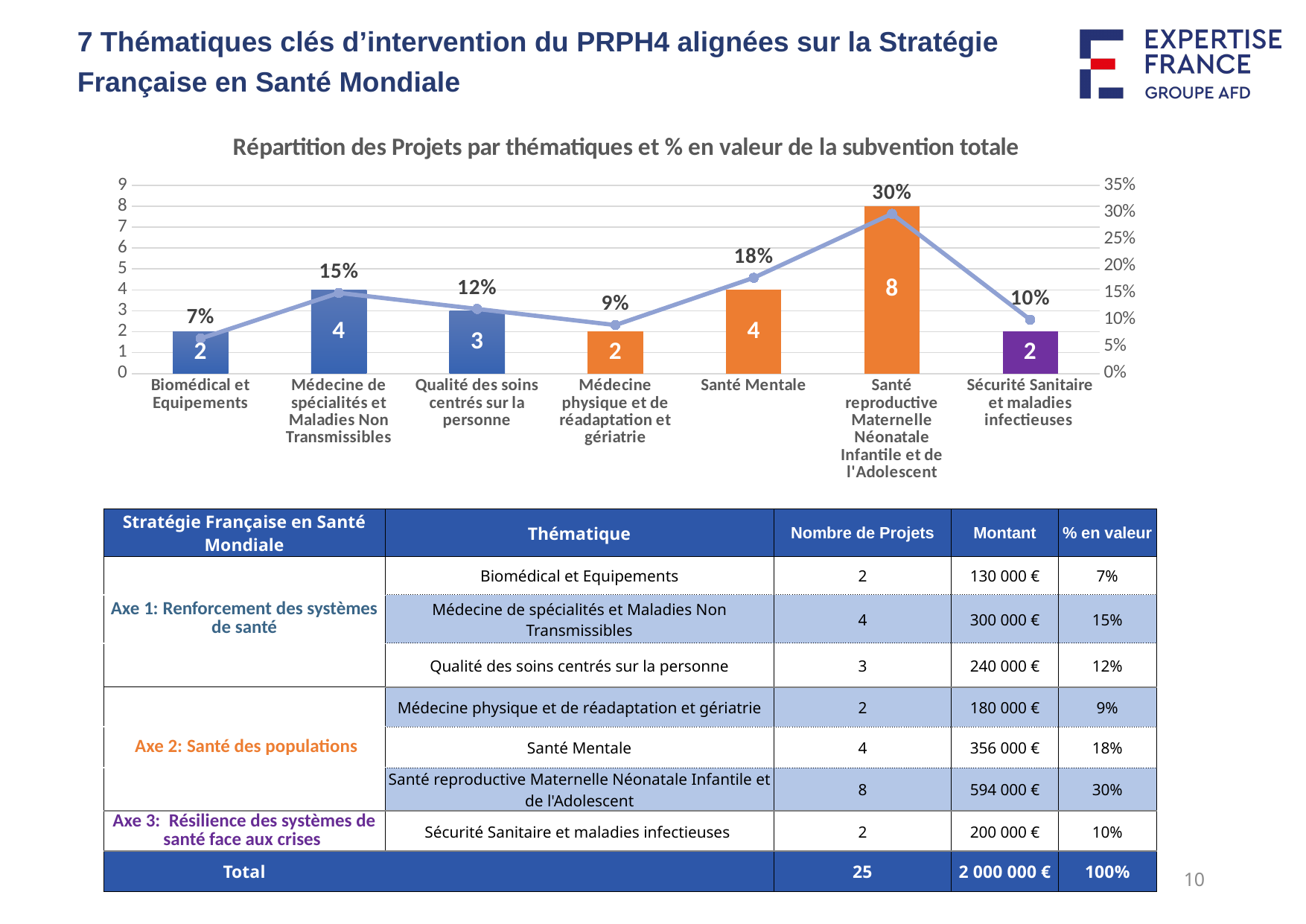
Which thematic has the lowest percentage of the total subvention in the chart? Biomédical et Equipements What percentage of the total subvention is shown for Médecine physique et de réadaptation et gériatrie? 9% What is the title of the chart? Répartition des Projets par thématiques et % en valeur de la subvention totale What is the difference in number of projects between Santé reproductive Maternelle Néonatale Infantile et de l'Adolescent and Qualité des soins centrés sur la personne? 5 How many thematic categories are plotted on the x axis of the chart? 7 What is the difference in percentage points between Santé Mentale and Qualité des soins centrés sur la personne? 6% Which thematic has the highest number of projects in the chart? Santé reproductive Maternelle Néonatale Infantile et de l'Adolescent What is the percentage value shown for Santé reproductive Maternelle Néonatale Infantile et de l'Adolescent? 30% What kind of chart is shown on the slide? A bar chart combined with a line chart Which has a larger share of the subvention: Médecine de spécialités et Maladies Non Transmissibles or Sécurité Sanitaire et maladies infectieuses? Médecine de spécialités et Maladies Non Transmissibles How many projects does the chart show for Santé Mentale? 4 What is the maximum value shown on the right-hand percentage axis of the chart? 35%